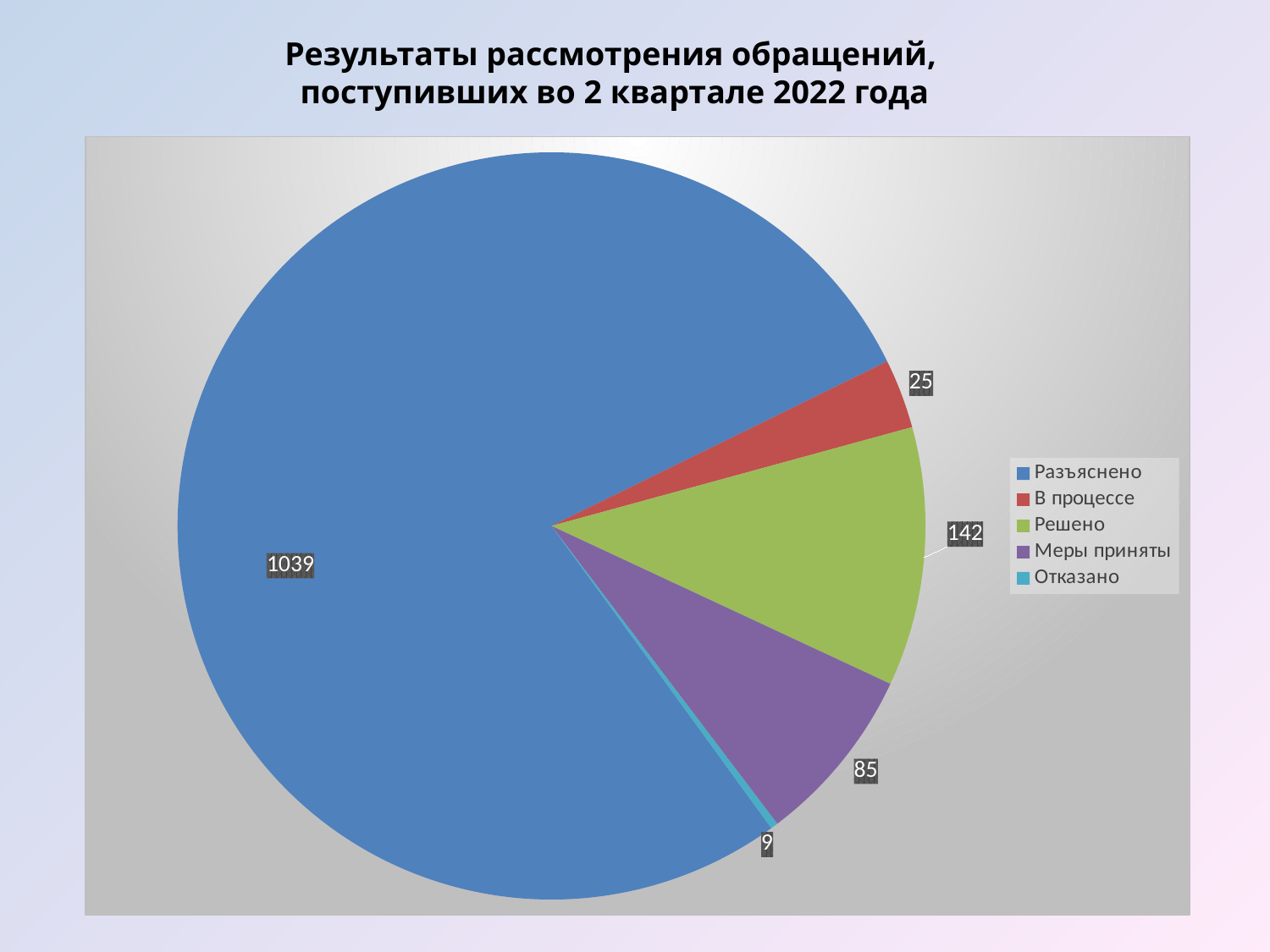
What is the value for Решено? 142 Which category has the smallest slice of the pie? Отказано Which is larger, the value for В процессе or the value for Меры приняты? Меры приняты What is the value for Разъяснено? 1039 What is the value for В процессе? 25 What type of chart is shown on the slide? pie chart What is the value for Меры приняты? 85 How many categories does the legend list? 5 What is the difference between the values for Решено and Меры приняты? 57 Which category has the largest slice of the pie? Разъяснено What is the value for Отказано? 9 What colour is the slice for Решено? green